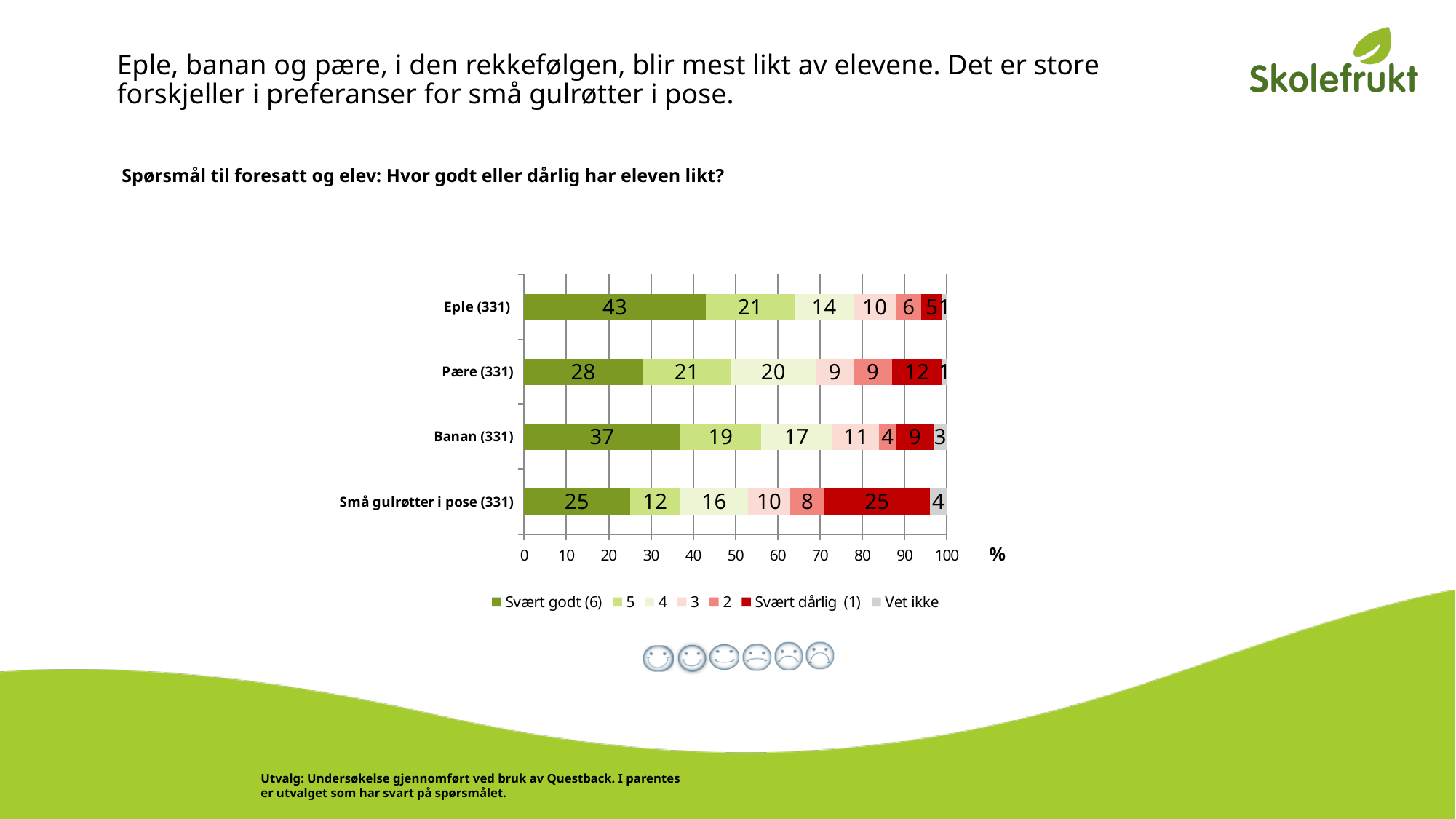
What percentage of respondents rated Små gulrøtter i pose as "Svært dårlig (1)"? 25 What is the value of the "4" segment for Pære? 20 How many series does the legend list? 7 What is the sample size shown in parentheses for each category? 331 What kind of chart is shown on the slide? Stacked bar chart Which has a larger "Svært dårlig (1)" share, Pære or Banan? Pære Which category has the lowest "Svært godt (6)" share? Små gulrøtter i pose (331) What percentage of respondents rated Eple as "Svært godt (6)"? 43 How many categories (fruit/vegetable items) are shown in the chart? 4 What is the difference between the "Svært godt (6)" values for Eple and Banan? 6 What is the "Vet ikke" value for Banan? 3 Which category has the highest "Svært godt (6)" share? Eple (331)